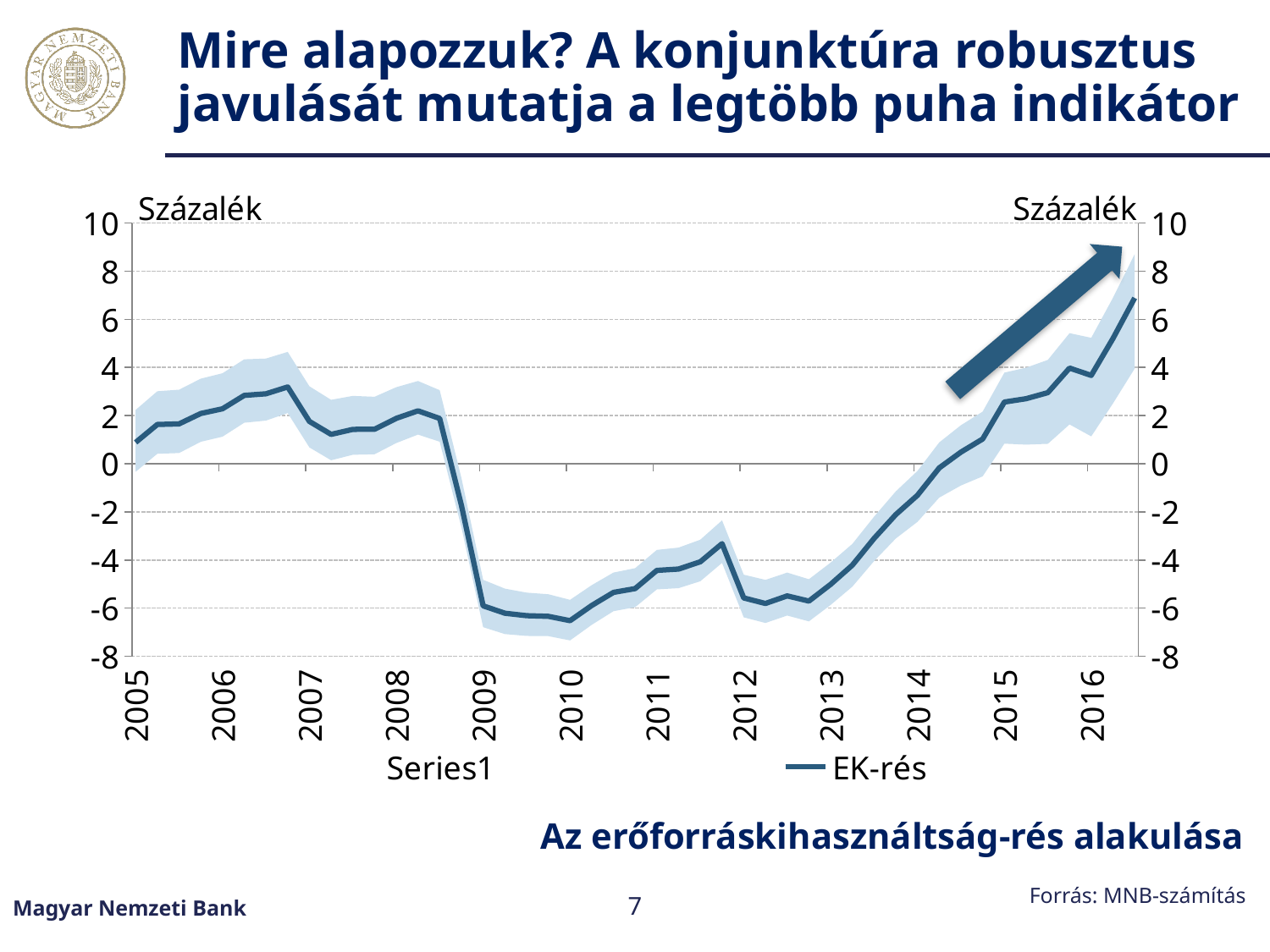
Is the EK-rés value at 2005 greater or less than 0? greater How many series does the legend list? 2 What are the two entries in the chart's legend? Series1 and EK-rés What kind of chart is shown on the slide? line chart Is the EK-rés value at 2009 greater or less than -4? less Does the EK-rés line rise or fall between 2013 and 2016? rise In which year does the EK-rés line reach its highest value? 2016 What is the title printed below the chart? Az erőforráskihasználtság-rés alakulása Is the EK-rés value at the end of 2016 greater or less than 4? greater Which is larger, the EK-rés value at 2016 or at 2010? 2016 How many year labels are shown on the x axis? 12